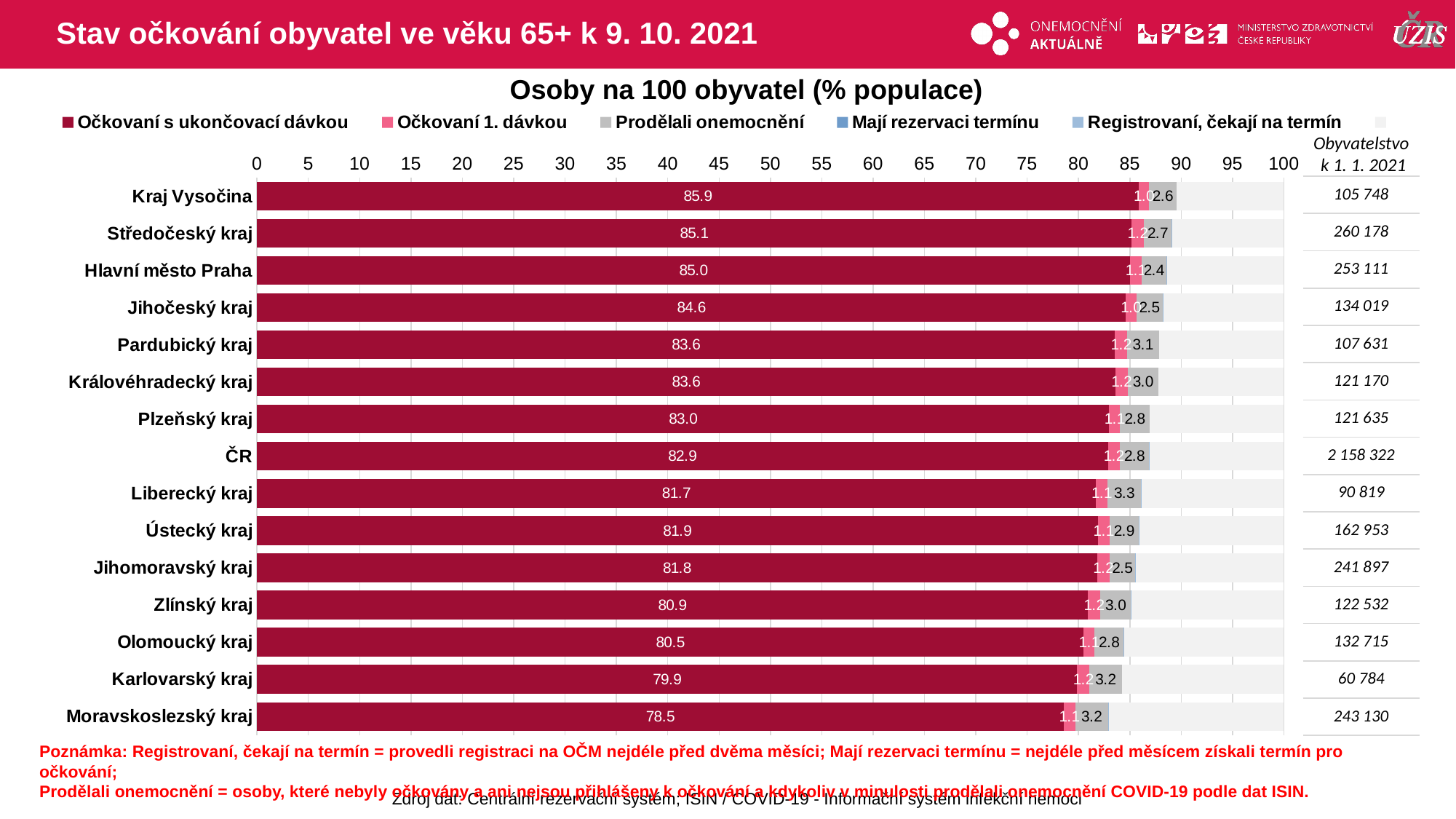
Which has a higher value of 'Očkovaní s ukončovací dávkou', Středočeský kraj or Karlovarský kraj? Středočeský kraj How many categories (rows) are plotted in the chart? 15 What is the title of the chart? Osoby na 100 obyvatel (% populace) What is the difference in 'Očkovaní s ukončovací dávkou' between Kraj Vysočina and Moravskoslezský kraj? 7.4 What is the value of 'Očkovaní s ukončovací dávkou' for Kraj Vysočina? 85.9 Which region has the lowest value of 'Očkovaní s ukončovací dávkou'? Moravskoslezský kraj Which region has the highest value of 'Očkovaní s ukončovací dávkou'? Kraj Vysočina Is the value of 'Očkovaní s ukončovací dávkou' for Olomoucký kraj greater or less than 85? less What is the value of 'Prodělali onemocnění' for Liberecký kraj? 3.3 How many labelled series does the legend list? 5 What is the value of 'Očkovaní s ukončovací dávkou' for ČR? 82.9 What type of chart is shown on the slide? stacked bar chart